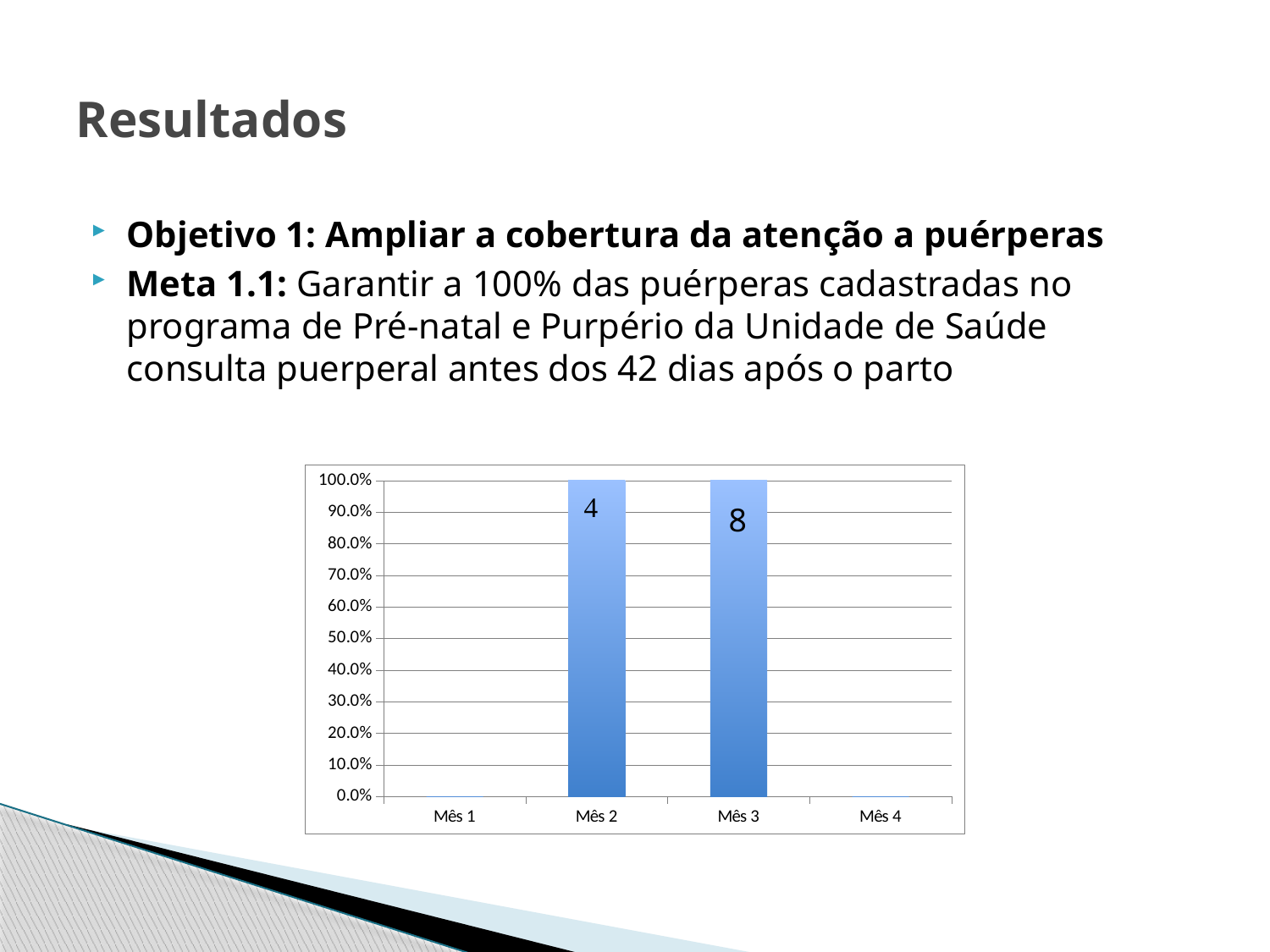
What kind of chart is shown on the slide? bar chart What is the label of the first category on the x axis? Mês 1 Is the value for Mês 3 greater or less than 90.0%? greater What percentage does the bar for Mês 3 reach on the y axis? 100.0% How many categories are shown on the x axis of the chart? 4 Which categories on the x axis have no visible bar? Mês 1 and Mês 4 What is the highest value shown on the y axis of the chart? 100.0% What is the difference between the data labels printed on the bars for Mês 3 and Mês 2? 4 Which bar has the larger printed data label, Mês 2 or Mês 3? Mês 3 What data label is printed on the bar for Mês 2? 4 What percentage does the bar for Mês 2 reach on the y axis? 100.0% What data label is printed on the bar for Mês 3? 8